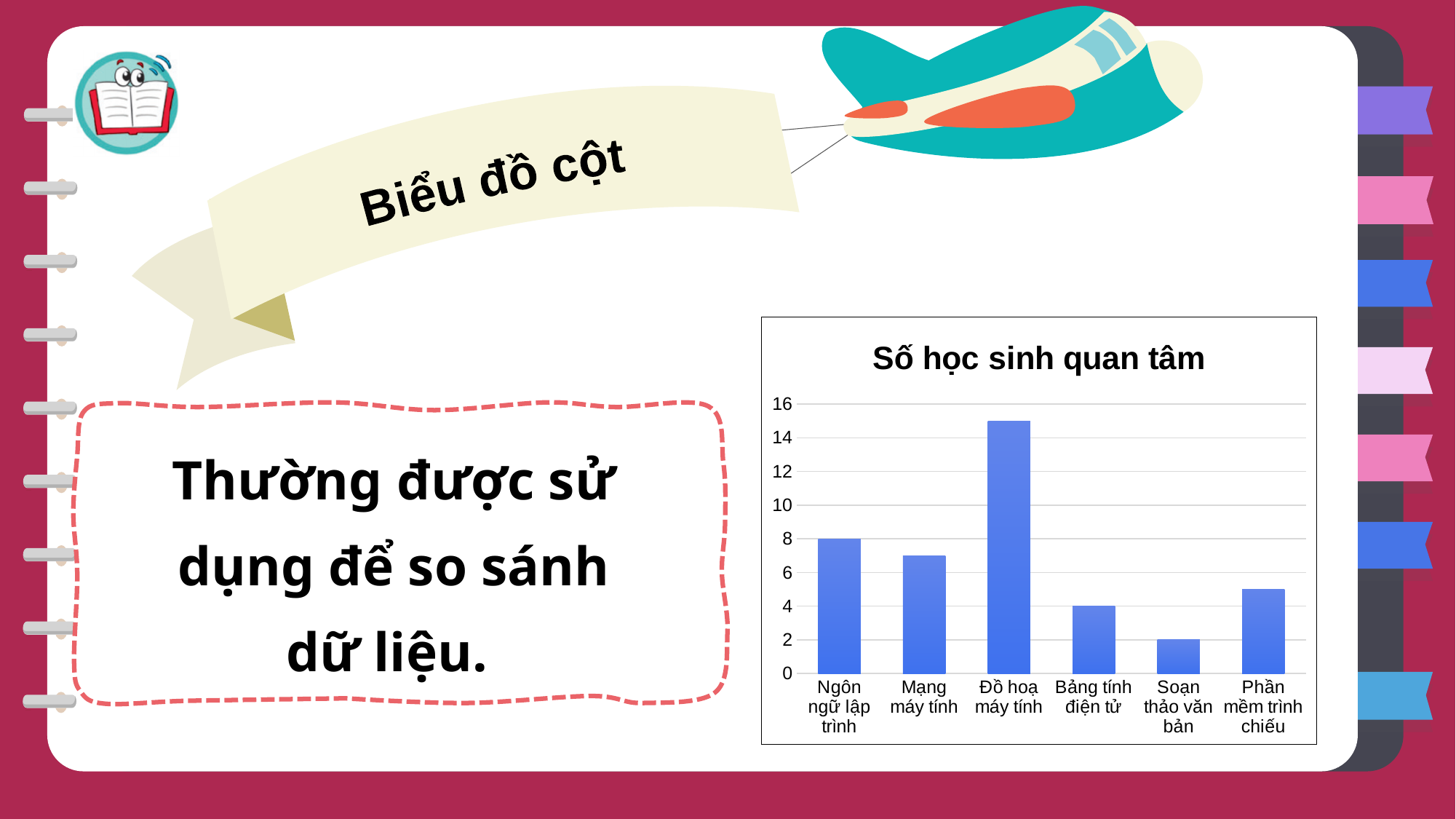
What kind of chart is shown on the slide? bar chart How many categories are shown on the x axis of the chart? 6 What is the value for Ngôn ngữ lập trình? 8 Which category has the highest value in the chart? Đồ hoạ máy tính Which category has the lowest value in the chart? Soạn thảo văn bản What is the value for Bảng tính điện tử? 4 Is the value for Đồ hoạ máy tính greater or less than 14? greater What is the value for Soạn thảo văn bản? 2 What is the title of the chart on the slide? Số học sinh quan tâm Which is larger, the value for Phần mềm trình chiếu or the value for Soạn thảo văn bản? Phần mềm trình chiếu Is the value for Mạng máy tính greater or less than 8? less What is the difference between the values for Ngôn ngữ lập trình and Bảng tính điện tử? 4